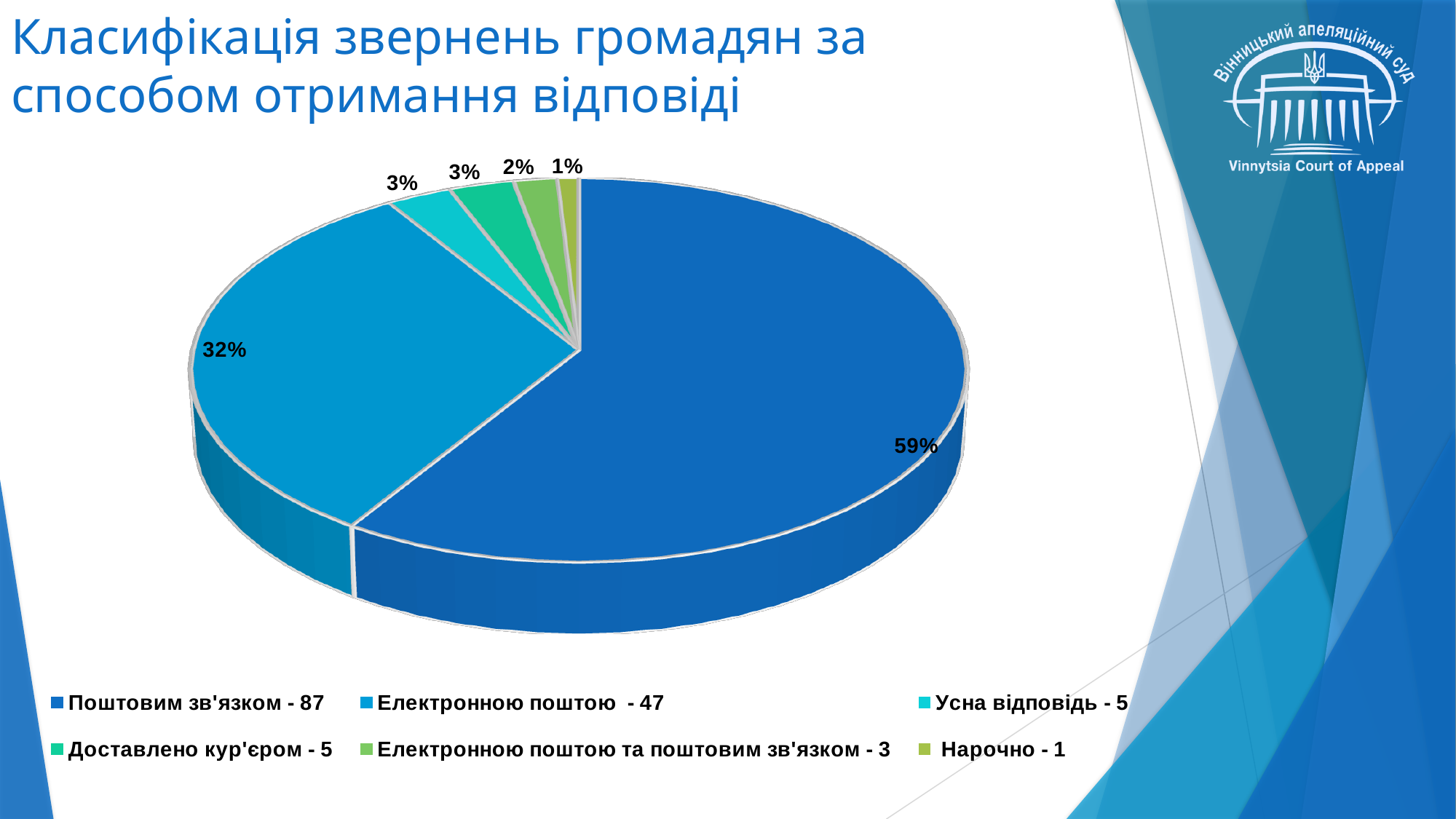
What is the title of the slide? Класифікація звернень громадян за способом отримання відповіді What kind of chart is shown on the slide? pie chart Which is larger: the "Електронною поштою" slice or the "Усна відповідь" slice? Електронною поштою What share of the pie does "Поштовим зв'язком" take? 59% What share of the pie does "Електронною поштою та поштовим зв'язком" take? 2% What share of the pie does "Електронною поштою" take? 32% Which category has the smallest slice of the pie? Нарочно According to the legend, how many appeals were answered by "Електронною поштою"? 47 What is the difference in percentage points between the "Поштовим зв'язком" slice and the "Електронною поштою" slice? 27 percentage points Which category has the largest slice of the pie? Поштовим зв'язком How many slices does the pie chart have? 6